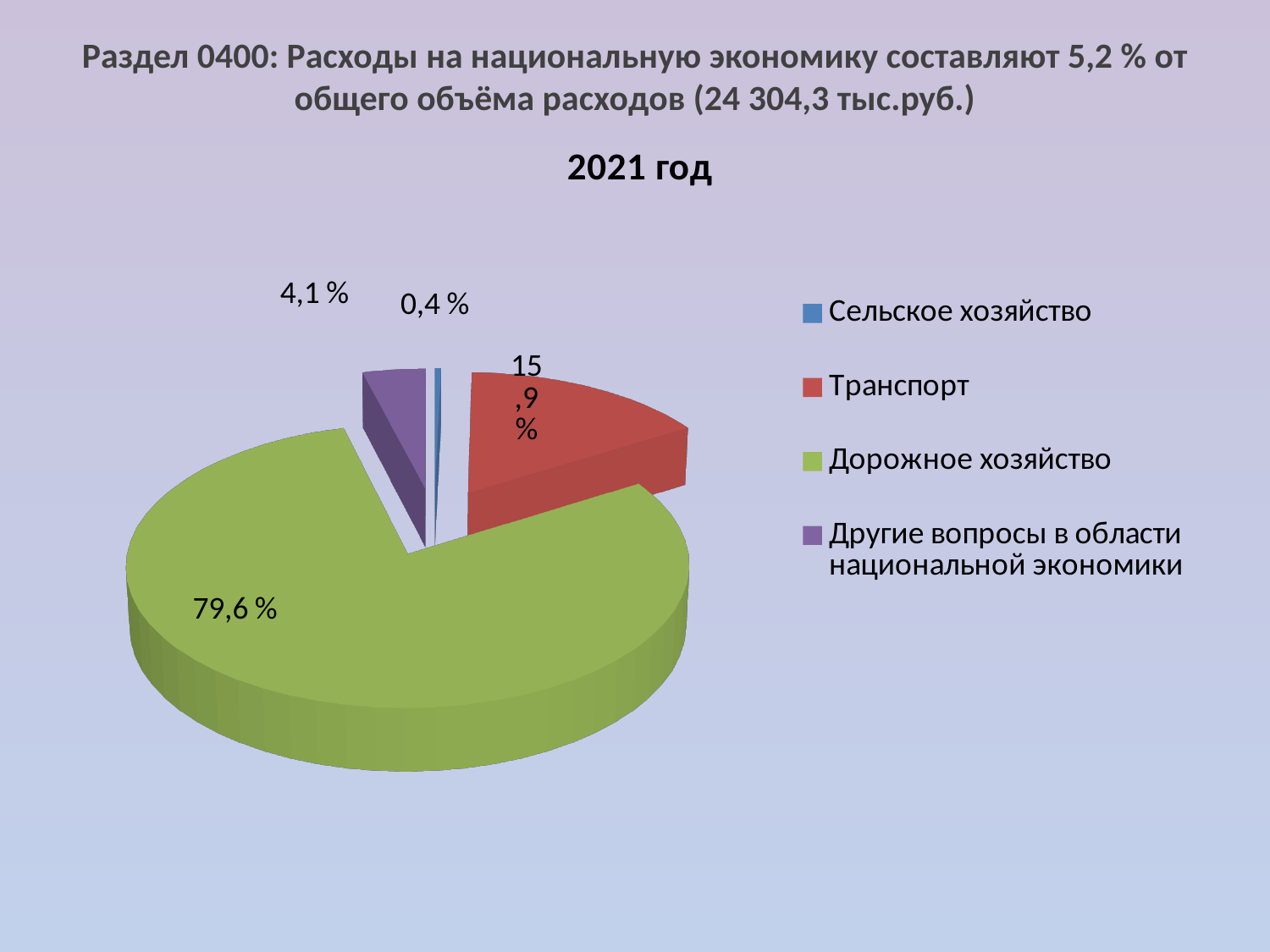
What is the value for Другие вопросы в области национальной экономики? 4,1 % Which category has the largest share of the pie? Дорожное хозяйство How many slices does the pie chart have? 4 Which category has the smallest share of the pie? Сельское хозяйство What is the value for Дорожное хозяйство? 79,6 % What is the value for Сельское хозяйство? 0,4 % What year is shown in the chart title? 2021 год What is the value for Транспорт? 15,9 % How many entries does the legend list? 4 What is the difference between the values for Дорожное хозяйство and Транспорт? 63,7 % Which is larger, the value for Транспорт or the value for Другие вопросы в области национальной экономики? Транспорт What kind of chart is shown on the slide? Pie chart